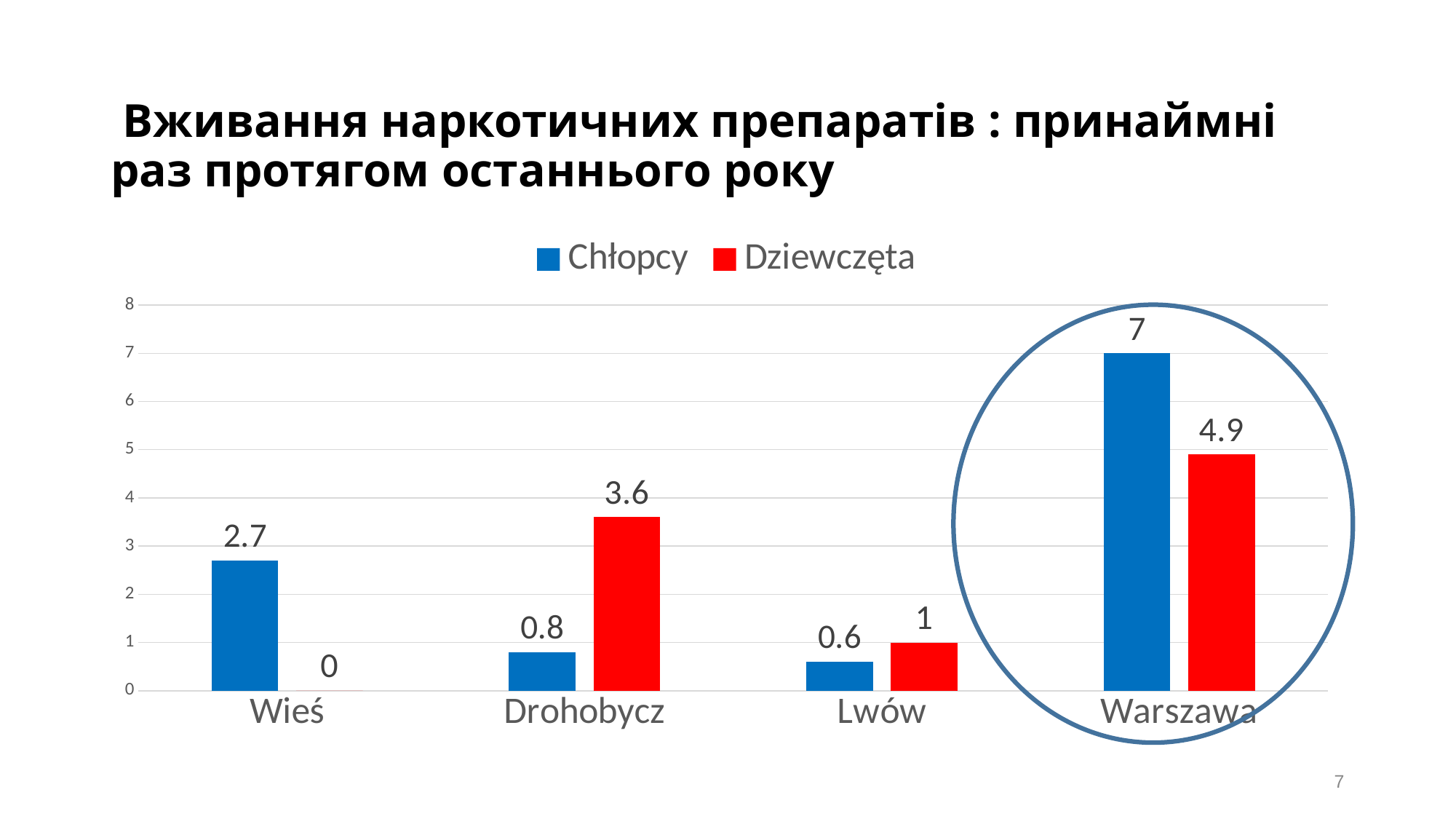
What is the difference between the Chłopcy and Dziewczęta values in Warszawa? 2.1 How many series does the legend list? 2 What kind of chart is shown on the slide? Bar chart Which category has the lowest value for Dziewczęta? Wieś How many categories are shown on the x axis? 4 What is the value for Dziewczęta in Wieś? 0 What is the value for Dziewczęta in Drohobycz? 3.6 Which category has the highest value for Chłopcy? Warszawa What is the value for Chłopcy in Warszawa? 7 What is the value for Chłopcy in Lwów? 0.6 In Drohobycz, which is larger: the value for Chłopcy or for Dziewczęta? Dziewczęta Which category is circled on the chart? Warszawa